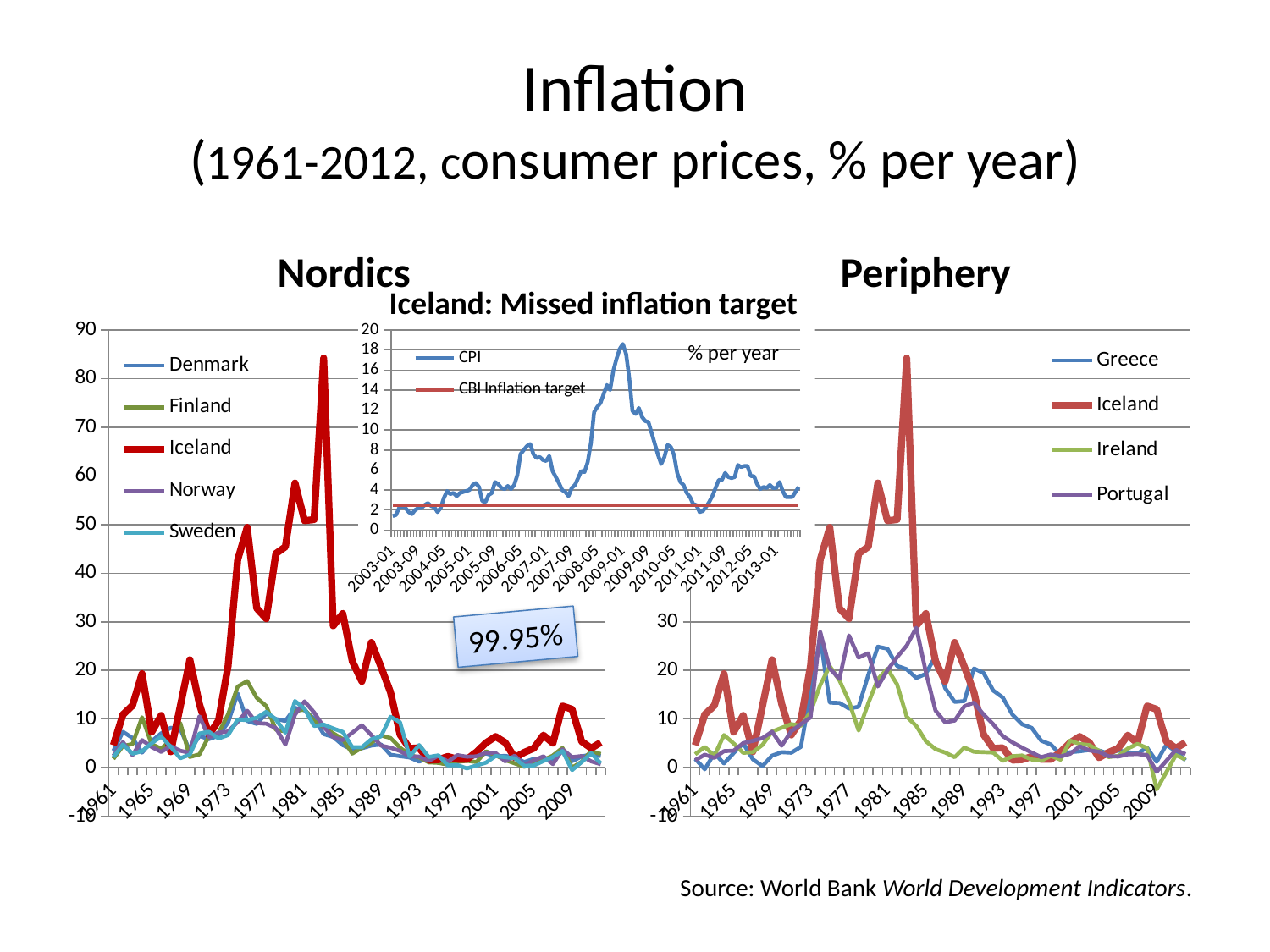
How many series does the legend of the inset chart titled 'Iceland: Missed inflation target' list? 2 In the Periphery chart, which country's line reaches the highest value? Iceland In the Nordics chart, which country's line reaches the highest value? Iceland How many series does the legend of the Nordics chart list? 5 In the inset chart 'Iceland: Missed inflation target', is the peak value of CPI greater or less than 16? greater In the inset chart 'Iceland: Missed inflation target', is the CBI Inflation target line greater or less than 4? less In the Nordics chart, does the Iceland line rise or fall between 1983 and 1993? Fall How many series does the legend of the Periphery chart list? 4 What kind of chart is the Nordics chart? Line chart In the Periphery chart, is the peak value for Iceland greater or less than 30? greater Which countries are listed in the legend of the Periphery chart? Greece, Iceland, Ireland, Portugal